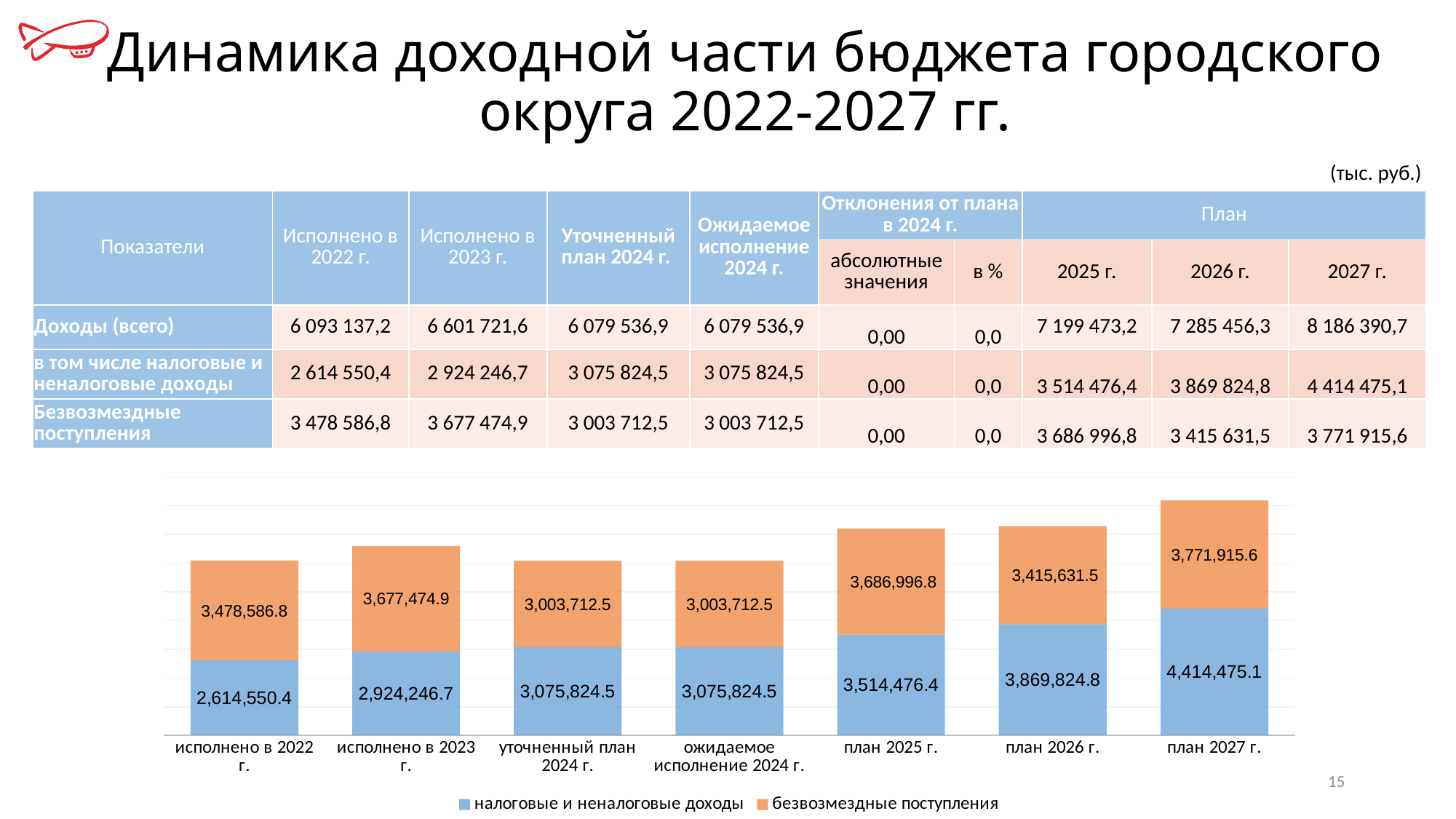
Which category has the highest value of налоговые и неналоговые доходы? план 2027 г. Which category has the lowest value of налоговые и неналоговые доходы? исполнено в 2022 г. How many categories are shown along the x axis of the chart? 7 For план 2026 г., which is larger: налоговые и неналоговые доходы or безвозмездные поступления? налоговые и неналоговые доходы What is the value of безвозмездные поступления for исполнено в 2023 г.? 3,677,474.9 What type of chart is shown on the slide? Stacked bar chart Which category has the highest value of безвозмездные поступления? план 2027 г. How many series does the chart legend list? 2 What is the value of налоговые и неналоговые доходы for план 2027 г.? 4,414,475.1 What is the value of безвозмездные поступления for план 2026 г.? 3,415,631.5 Do the values of налоговые и неналоговые доходы rise or fall from исполнено в 2022 г. to план 2027 г.? Rise What is the total of the stacked bar for план 2027 г.? 8,186,390.7